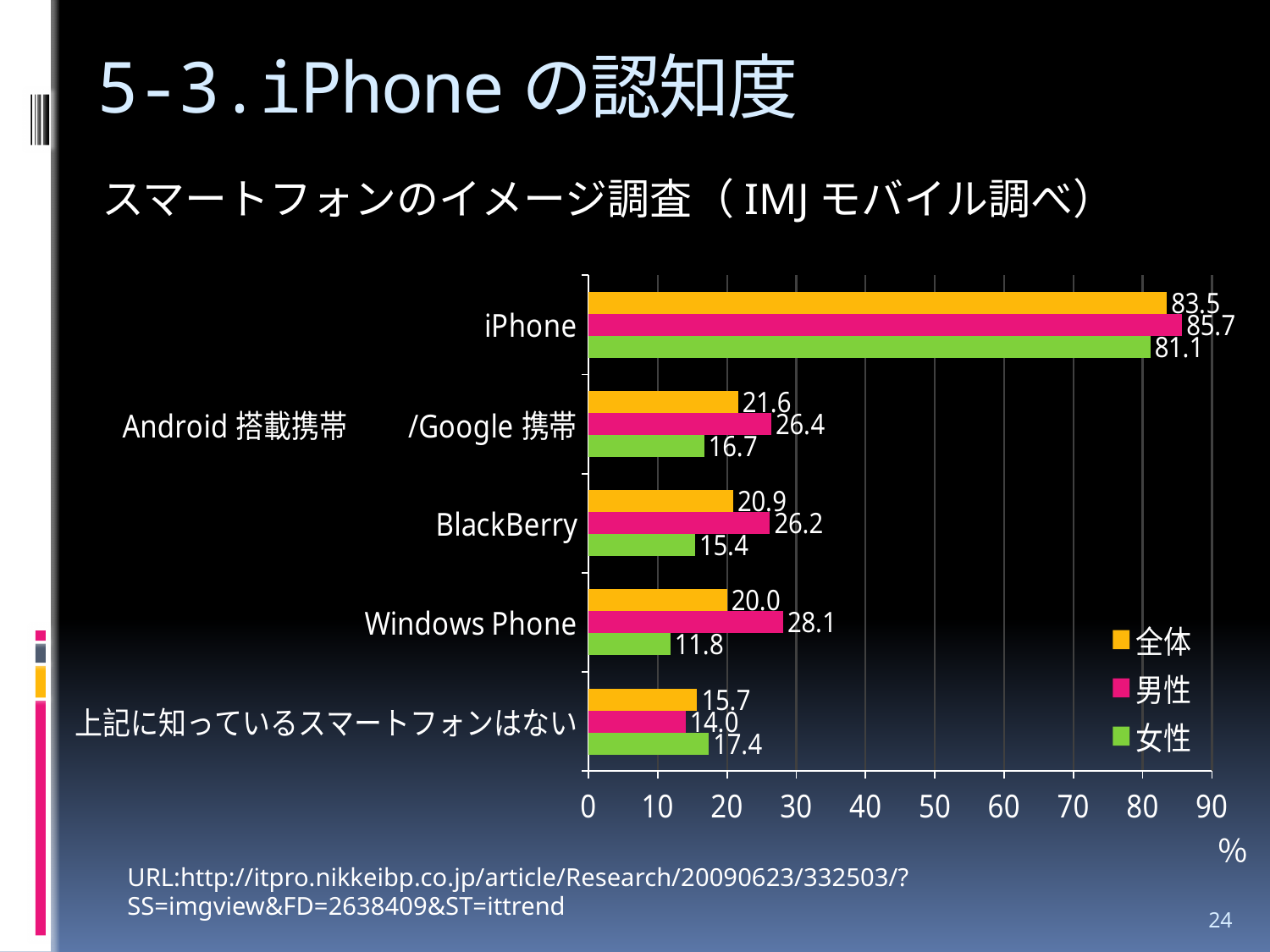
What is the 男性 value for Windows Phone? 28.1 Which category has the lowest 女性 value? Windows Phone How many categories are shown on the chart? 5 What kind of chart is shown on the slide? bar chart What is the 全体 value for iPhone? 83.5 Is the 全体 value for Android 搭載携帯/Google 携帯 greater or less than 20? greater Which category has the highest 男性 value? iPhone What is the 女性 value for BlackBerry? 15.4 How many series does the legend list? 3 What is the 女性 value for 上記に知っているスマートフォンはない? 17.4 What is the difference between the 男性 and 女性 values for iPhone? 4.6 Which is larger for BlackBerry, the 全体 value or the 男性 value? 男性